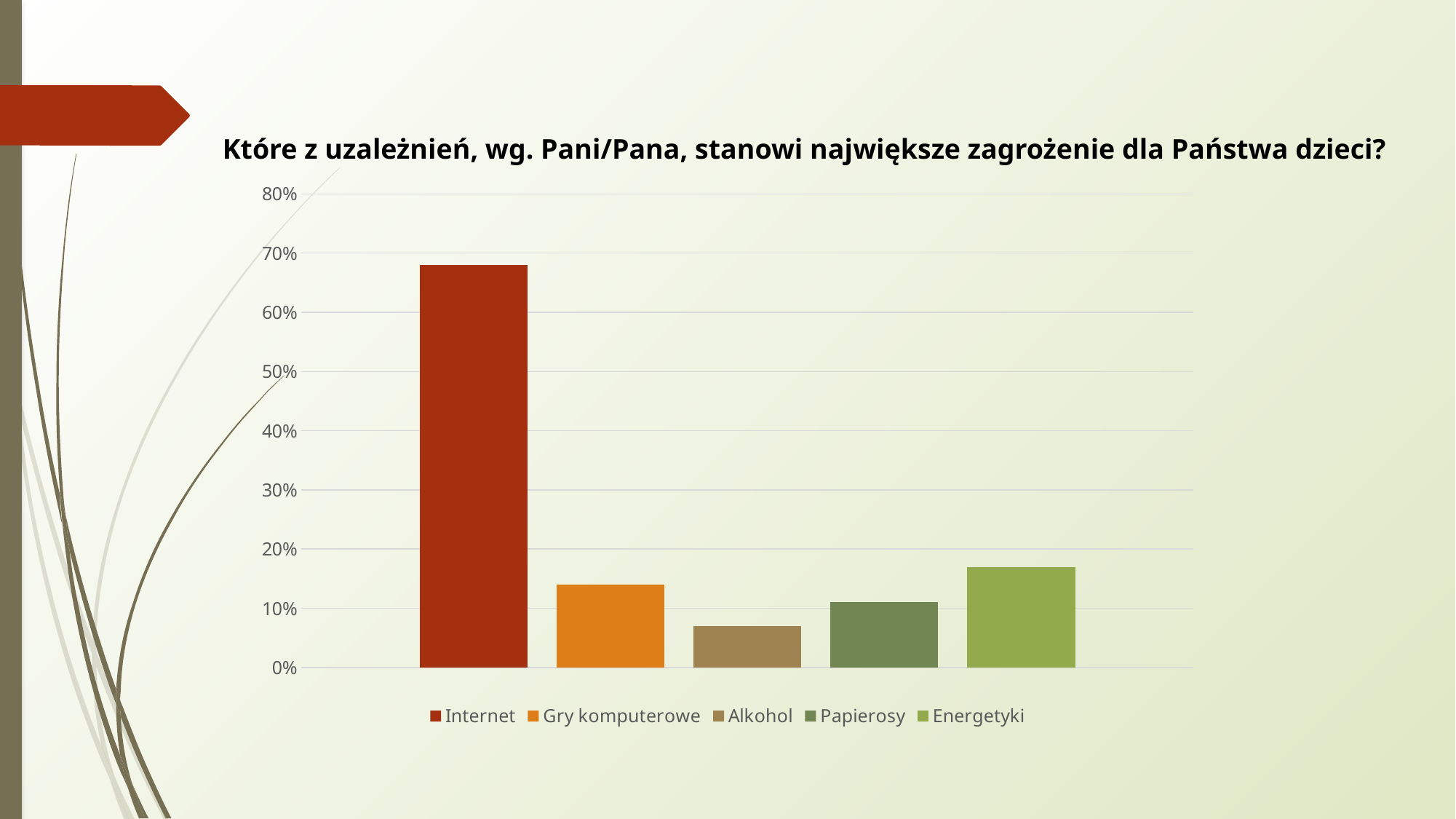
Is the value for Internet greater or less than 60%? greater What type of chart is shown on the slide? bar chart What is the title of the chart? Które z uzależnień, wg. Pani/Pana, stanowi największe zagrożenie dla Państwa dzieci? Which category has the highest value? Internet Which is larger, the value for Energetyki or the value for Gry komputerowe? Energetyki Which category has the lowest value? Alkohol Is the value for Energetyki greater or less than 20%? less Is the value for Alkohol greater or less than 10%? less Which is larger, the value for Papierosy or the value for Alkohol? Papierosy How many bars are plotted in the chart? 5 How many entries does the legend list? 5